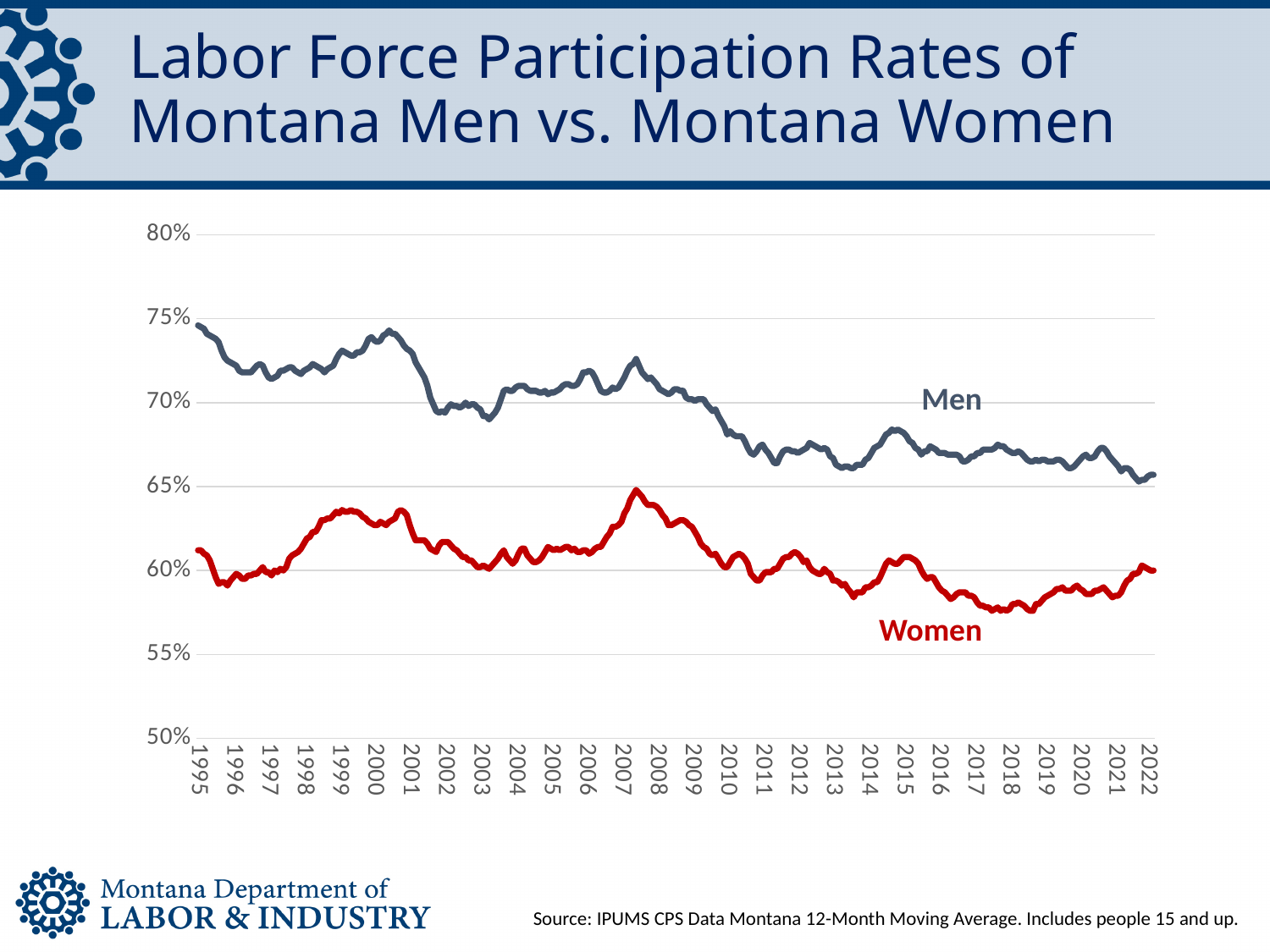
How many year labels are shown on the x axis? 28 Is the value for Women in 2022 greater or less than 55%? greater How many series are plotted on the chart? 2 What is the title of the chart on the slide? Labor Force Participation Rates of Montana Men vs. Montana Women Is the value for Men in 2022 greater or less than 70%? less Is the value for Men in 1995 greater or less than 70%? greater Which series has the higher labor force participation rate throughout the period, Men or Women? Men What are the two series plotted on the chart? Men and Women Overall, does the Men series rise or fall from 1995 to 2022? fall What kind of chart is shown on the slide? line chart